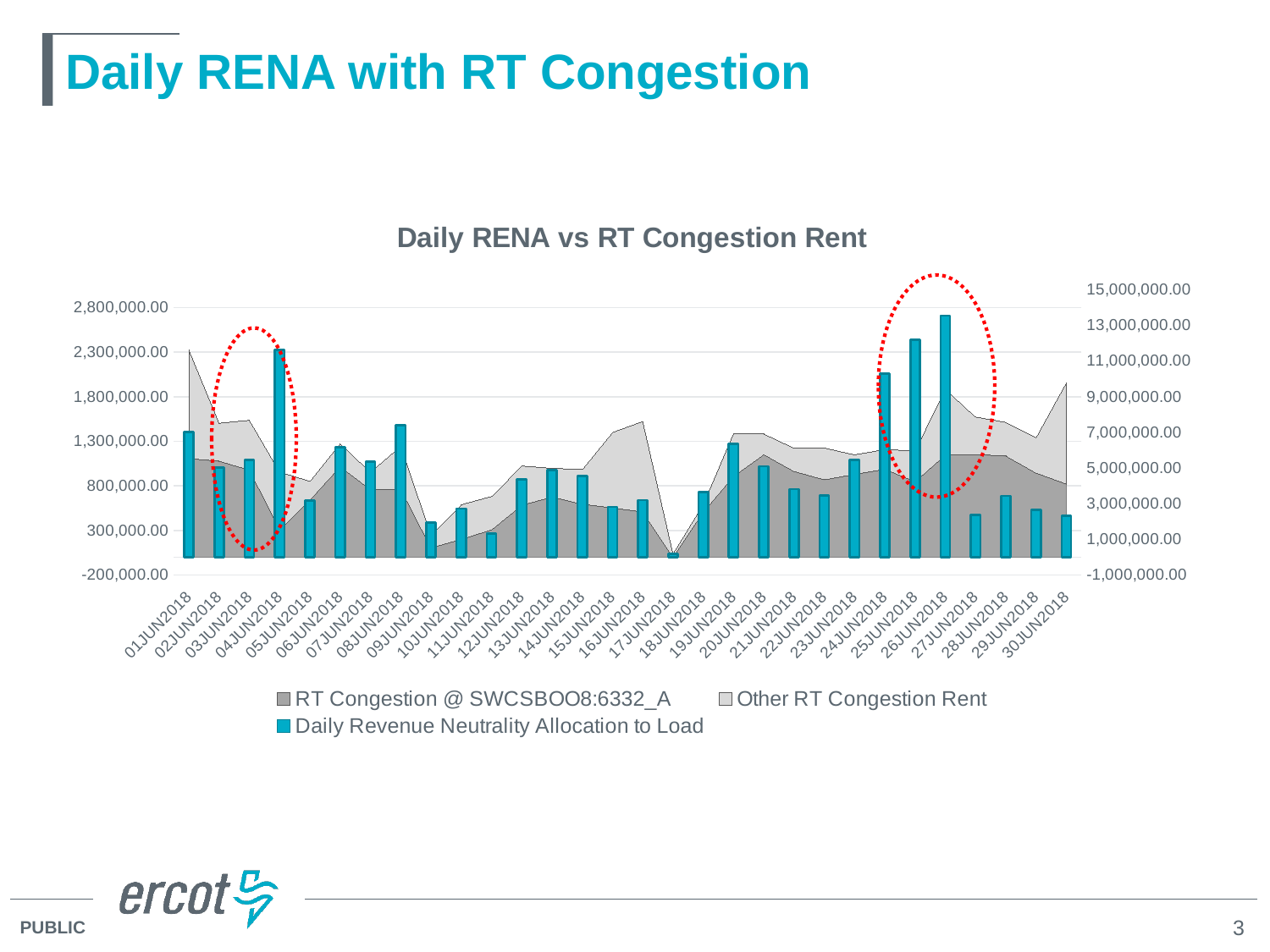
Which date has the taller Daily Revenue Neutrality Allocation to Load bar, 08JUN2018 or 09JUN2018? 08JUN2018 What is the title of the chart on the slide? Daily RENA vs RT Congestion Rent How many red dotted ovals are drawn on the chart to highlight data? 2 Which date has the tallest bar for Daily Revenue Neutrality Allocation to Load? 26JUN2018 Which date has the taller Daily Revenue Neutrality Allocation to Load bar, 04JUN2018 or 05JUN2018? 04JUN2018 On the left axis, is the Daily Revenue Neutrality Allocation to Load bar for 09JUN2018 greater or less than 800,000.00? less On the left axis, is the Daily Revenue Neutrality Allocation to Load bar for 04JUN2018 greater or less than 1,800,000.00? greater What kind of chart is shown on the slide? Combined bar and area chart Which date has the lowest bar for Daily Revenue Neutrality Allocation to Load? 17JUN2018 How many series does the chart legend list? 3 Which date has the taller Daily Revenue Neutrality Allocation to Load bar, 25JUN2018 or 26JUN2018? 26JUN2018 How many dates are shown along the x axis of the chart? 30